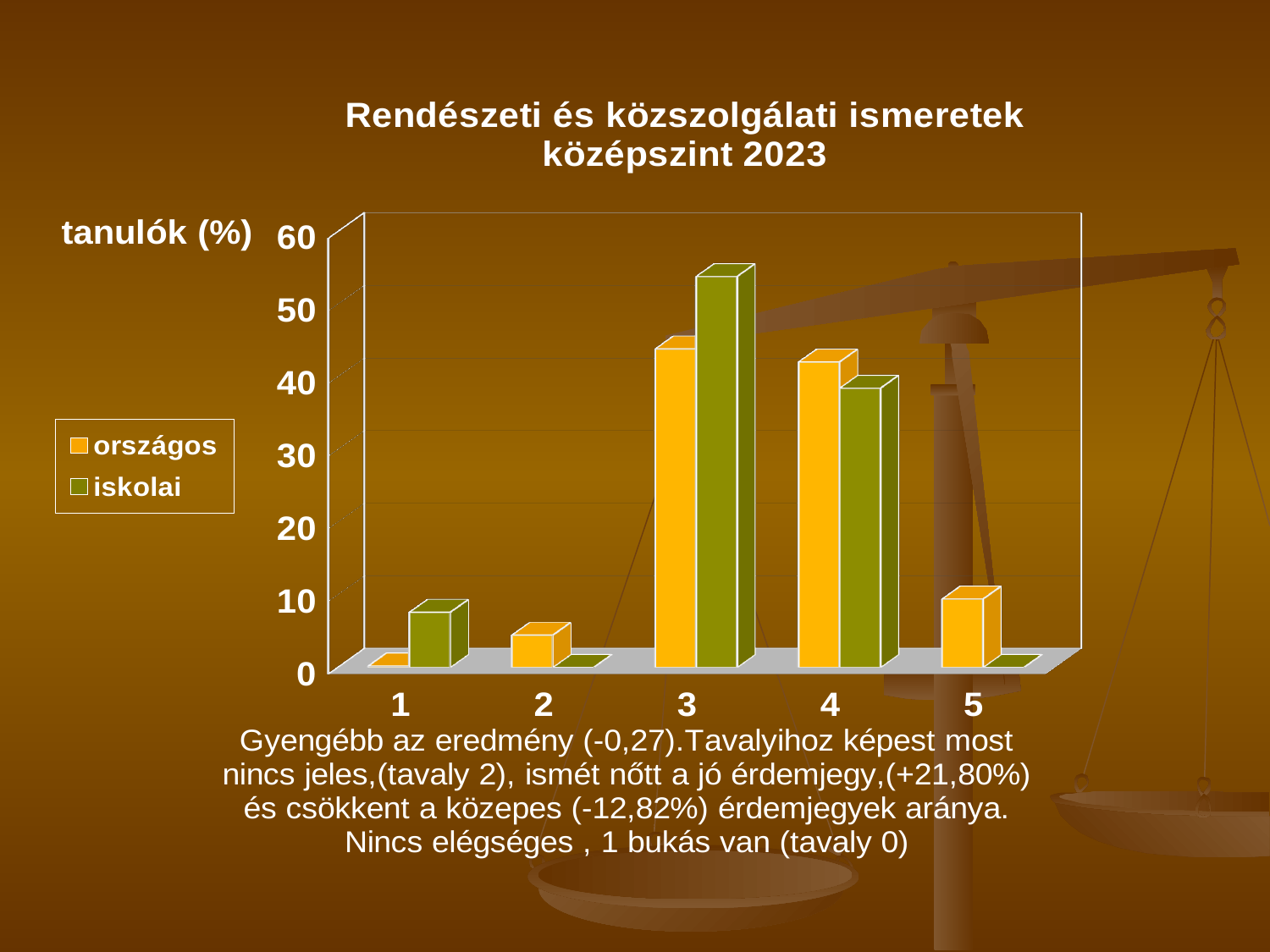
Is the országos value for category 5 greater or less than 20? less How many series does the legend list? 2 Is the iskolai value for category 3 greater or less than 50? greater For category 3, which series has the larger value, országos or iskolai? iskolai For category 5, which series has the larger value, országos or iskolai? országos Is the országos value for category 3 greater or less than 40? greater What is the title of the chart? Rendészeti és közszolgálati ismeretek középszint 2023 What kind of chart is shown on the slide? bar chart Which category has the highest value for the iskolai series? 3 How many categories are shown on the x axis? 5 Which category has the highest value for the országos series? 3